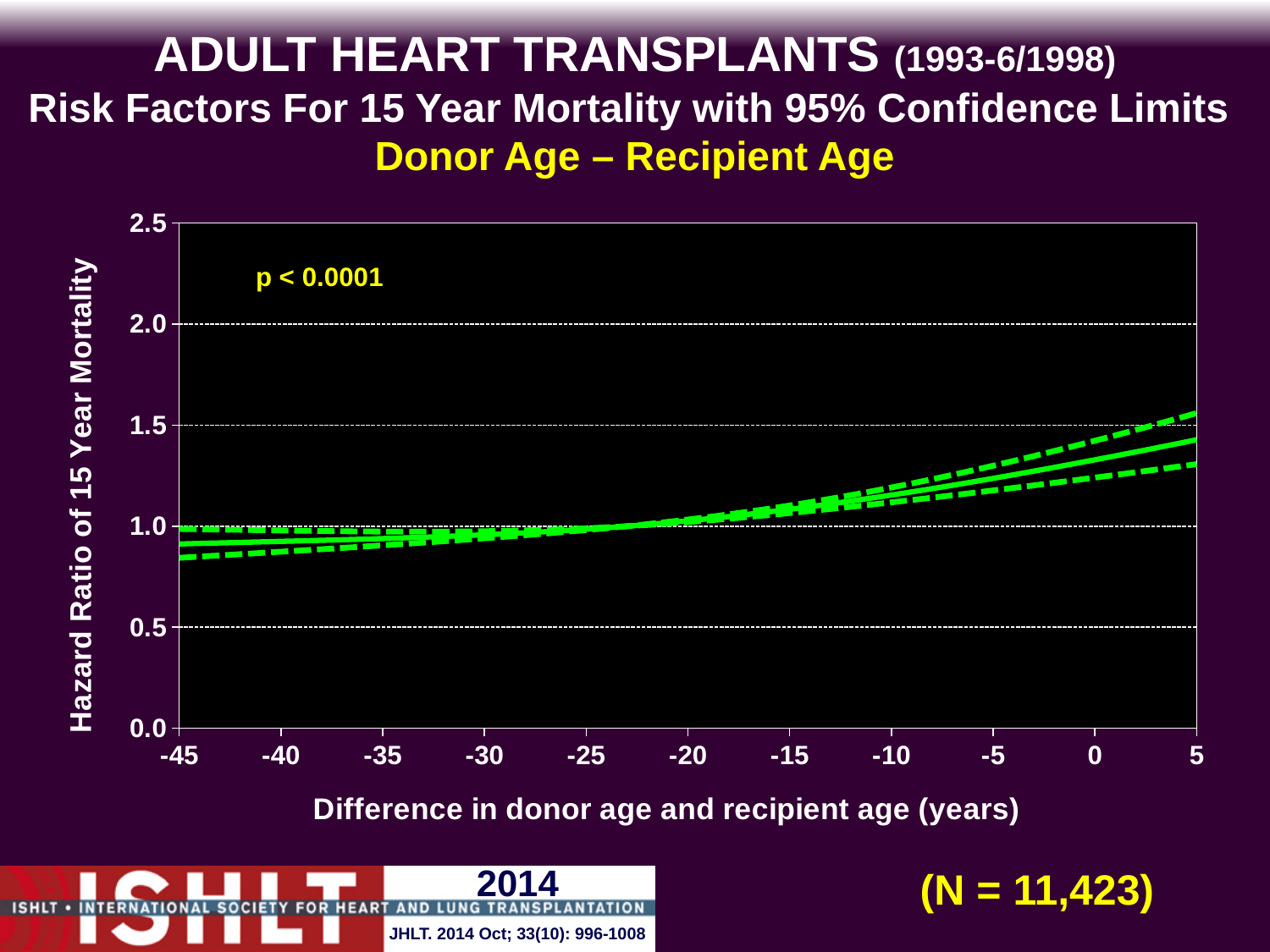
Is the upper dashed confidence limit at a donor-recipient age difference of 5 years greater or less than 1.5? greater Is the hazard ratio of the solid line at a donor-recipient age difference of 5 years greater or less than 1.0? greater How many lines are plotted on the chart? 3 Is the hazard ratio of the solid line at a donor-recipient age difference of -45 years greater or less than 1.0? less Does the hazard ratio rise or fall as the difference in donor age and recipient age increases from -45 to 5 years? rise What p-value is printed on the chart? p < 0.0001 What kind of chart is shown on the slide? line chart What is the label of the y axis? Hazard Ratio of 15 Year Mortality What is the highest value shown on the y axis? 2.5 What is the lowest value shown on the x axis? -45